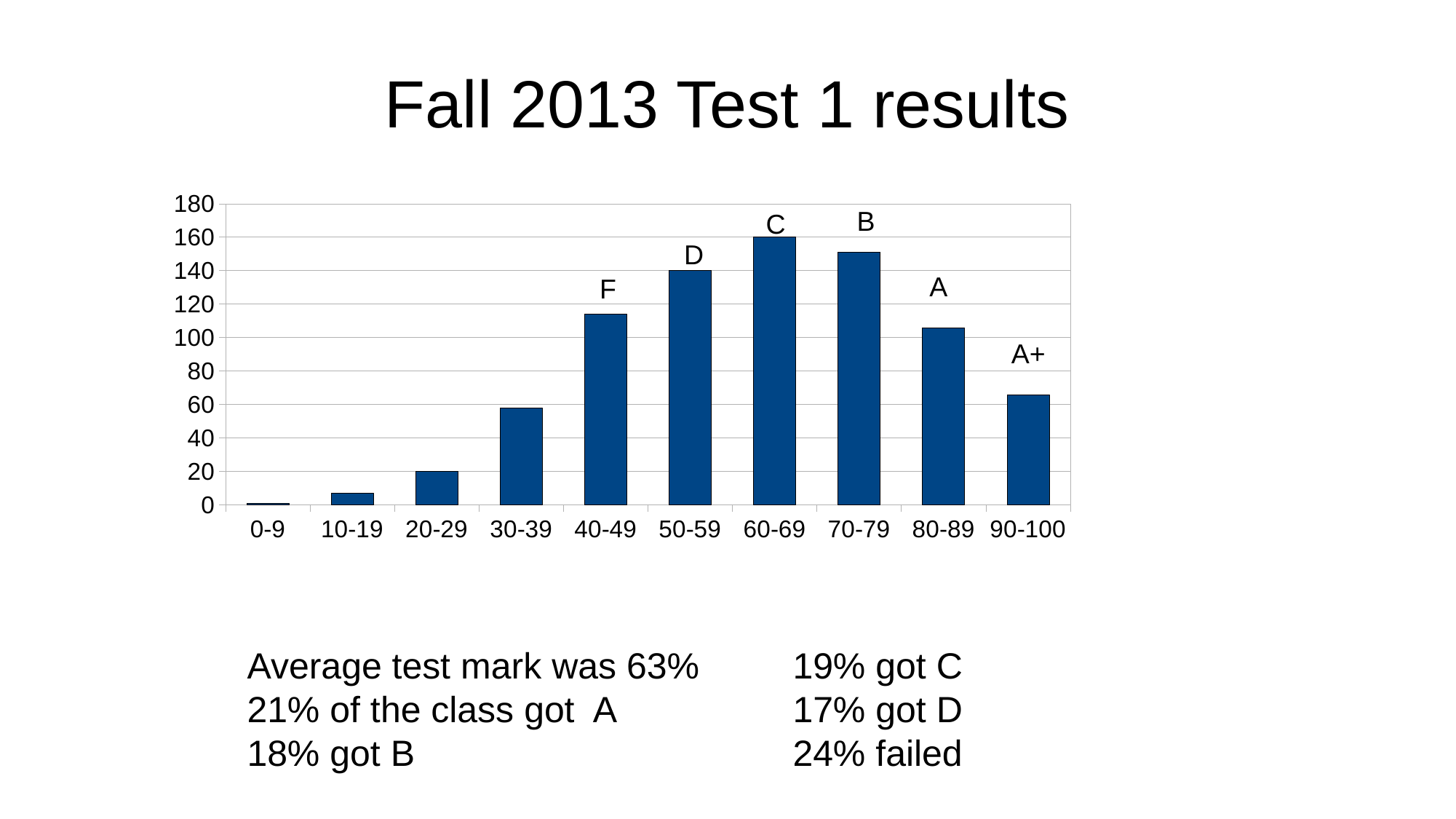
Which score range has the highest bar? 60-69 How many score ranges are shown on the x axis of the chart? 10 Do the values rise or fall from 0-9 to 60-69? rise Which is larger, the value for 70-79 or the value for 80-89? 70-79 Is the value for 90-100 greater or less than 80? less Which score range has the lowest bar? 0-9 Which is larger, the value for 40-49 or the value for 50-59? 50-59 Is the value for 80-89 greater or less than 100? greater What grade letter is printed above the 60-69 bar? C What kind of chart is shown on the slide? bar chart Is the value for 40-49 greater or less than 100? greater